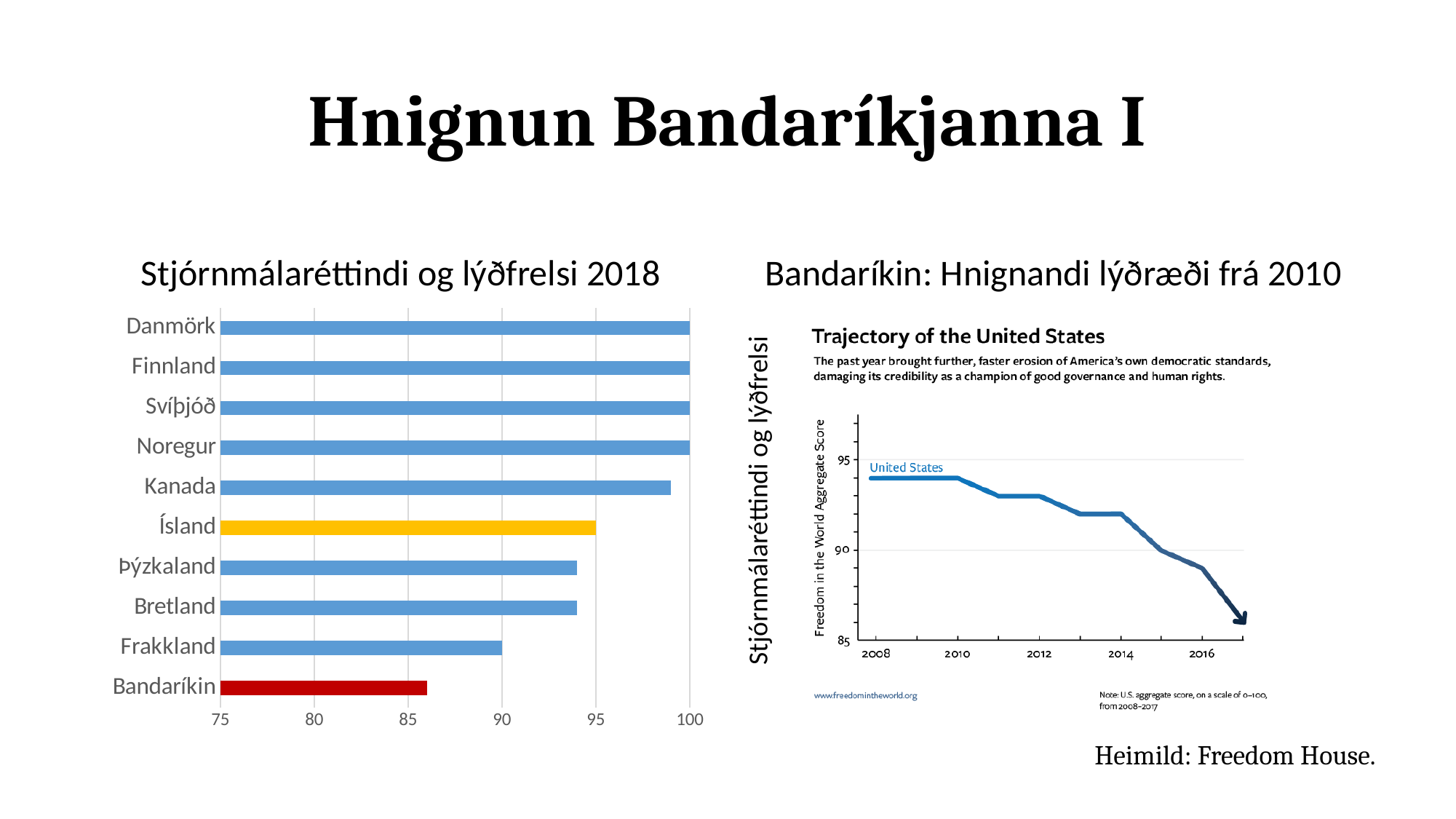
In the chart "Stjórnmálaréttindi og lýðfrelsi 2018", which country has the lowest value? Bandaríkin In the chart "Stjórnmálaréttindi og lýðfrelsi 2018", what is the value for Frakkland? 90 How many countries are shown in the chart "Stjórnmálaréttindi og lýðfrelsi 2018"? 10 What kind of chart is the chart titled "Stjórnmálaréttindi og lýðfrelsi 2018"? Bar chart In the chart "Trajectory of the United States", does the United States score rise or fall from 2010 to 2017? Fall What kind of chart is the chart titled "Trajectory of the United States" on the right of the slide? Line chart In the chart "Stjórnmálaréttindi og lýðfrelsi 2018", which has the larger value, Kanada or Ísland? Kanada In the chart "Stjórnmálaréttindi og lýðfrelsi 2018", what is the value for Ísland? 95 In the chart "Stjórnmálaréttindi og lýðfrelsi 2018", what is the value for Danmörk? 100 In the chart "Stjórnmálaréttindi og lýðfrelsi 2018", is the value for Bandaríkin greater or less than 90? less In the chart "Stjórnmálaréttindi og lýðfrelsi 2018", what colour is the bar for Bandaríkin? Red In the chart "Stjórnmálaréttindi og lýðfrelsi 2018", is the value for Kanada greater or less than 95? greater